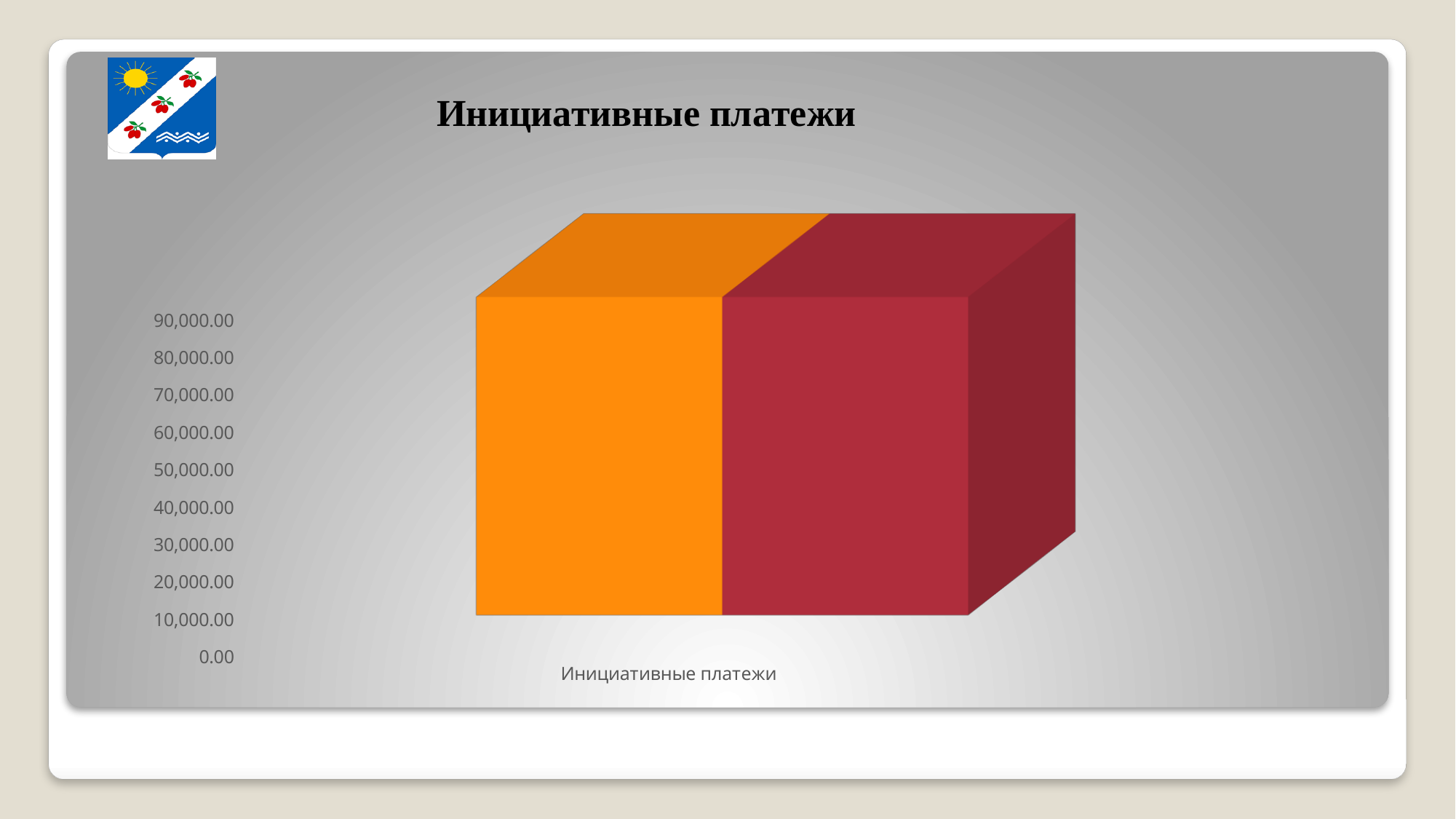
Is the value of the orange bar greater or less than 80,000.00? greater Is the value of the orange bar greater or less than 50,000.00? greater Is the value of the red bar greater or less than 80,000.00? greater What is the title of the chart? Инициативные платежи How many categories are shown on the x axis of the chart? 1 What kind of chart is shown on the slide? bar chart How many bars are plotted in the chart? 2 What colours are the two bars in the chart? orange and red